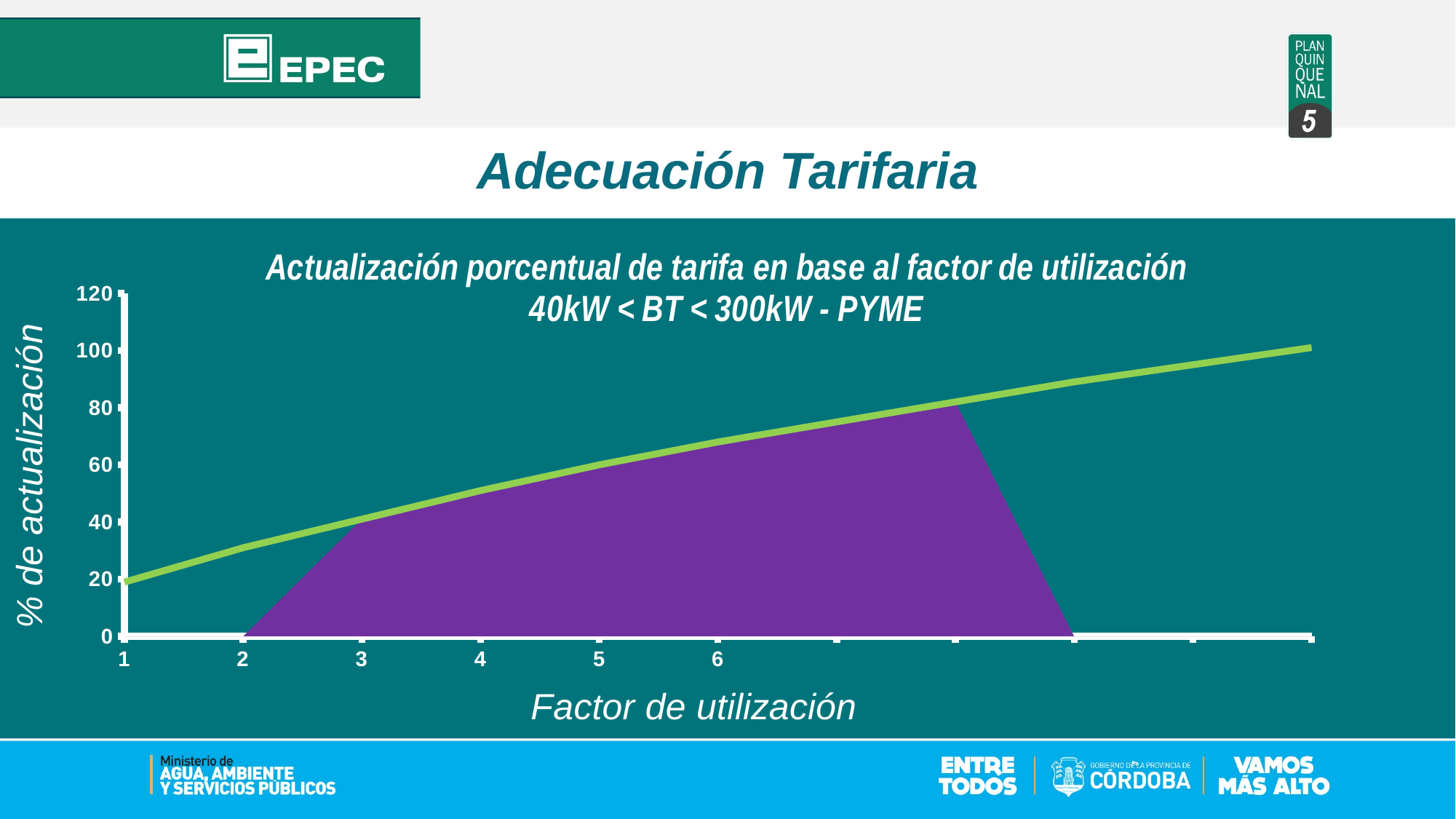
Is the value for Factor de utilización 6 greater or less than 80? less What is the title of the y axis? % de actualización Among the labeled x-axis values 1 to 6, which has the lowest % de actualización? 1 Is the value for Factor de utilización 2 greater or less than 40? less Is the value for Factor de utilización 4 greater or less than 60? less Among the labeled x-axis values 1 to 6, which has the highest % de actualización? 6 Which has the larger % de actualización, Factor de utilización 2 or 6? 6 What kind of chart is shown on the slide? combination area and line chart What is the title of the x axis? Factor de utilización Does the % de actualización rise or fall as the Factor de utilización increases? rise